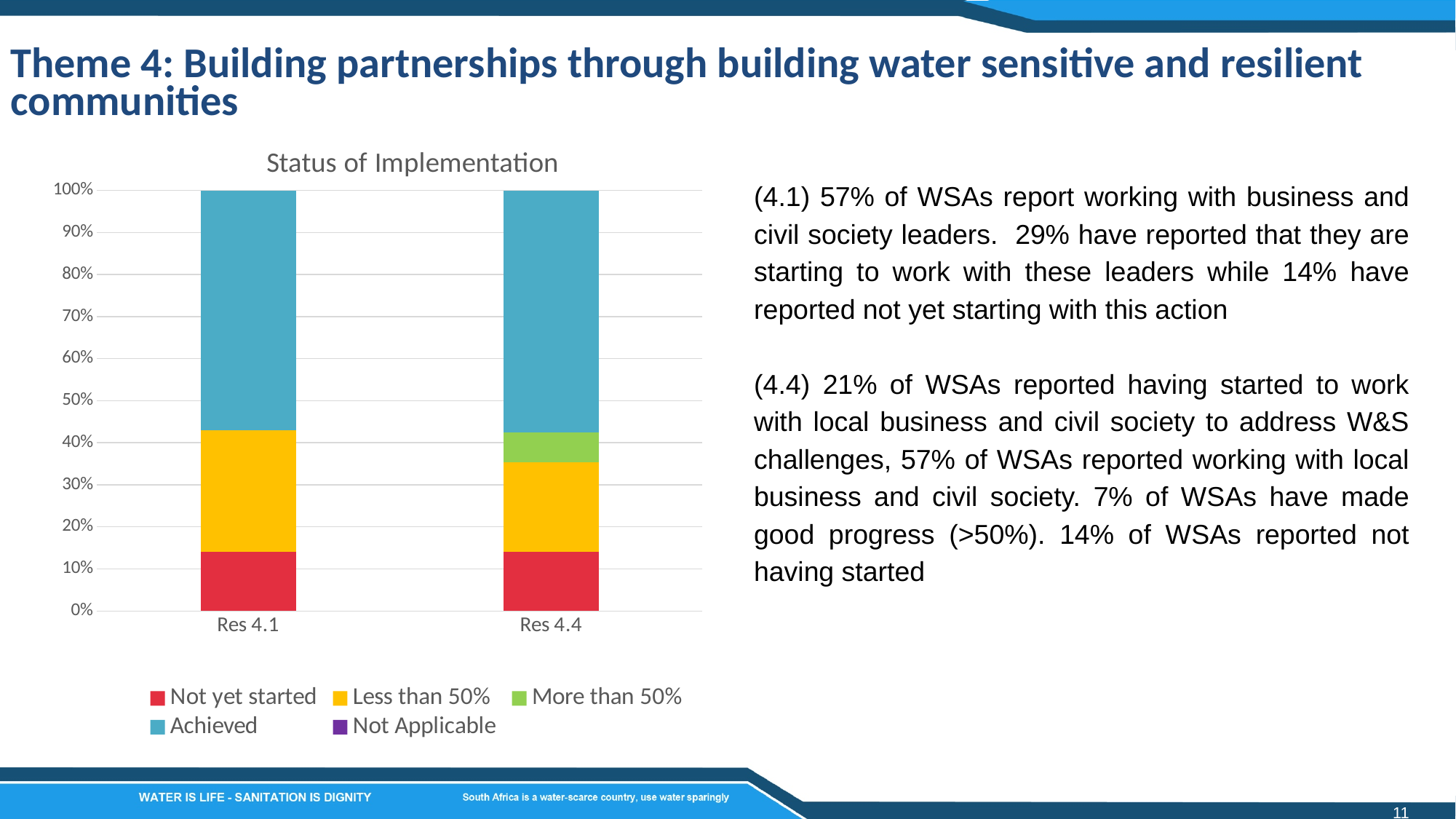
How many categories are shown on the x axis of the chart? 2 Is the 'More than 50%' segment for Res 4.4 greater or less than 10%? less What type of chart is shown on the slide? Stacked bar chart What is the total height of the stacked bar for Res 4.1? 100% Is the 'Not yet started' segment for Res 4.1 greater or less than 20%? less Is the 'Achieved' segment for Res 4.1 greater or less than 50%? greater What are the two categories on the x axis? Res 4.1 and Res 4.4 Which category has a visible 'More than 50%' segment? Res 4.4 What is the title of the chart? Status of Implementation For Res 4.1, which segment is larger: 'Achieved' or 'Less than 50%'? Achieved How many series does the chart legend list? 5